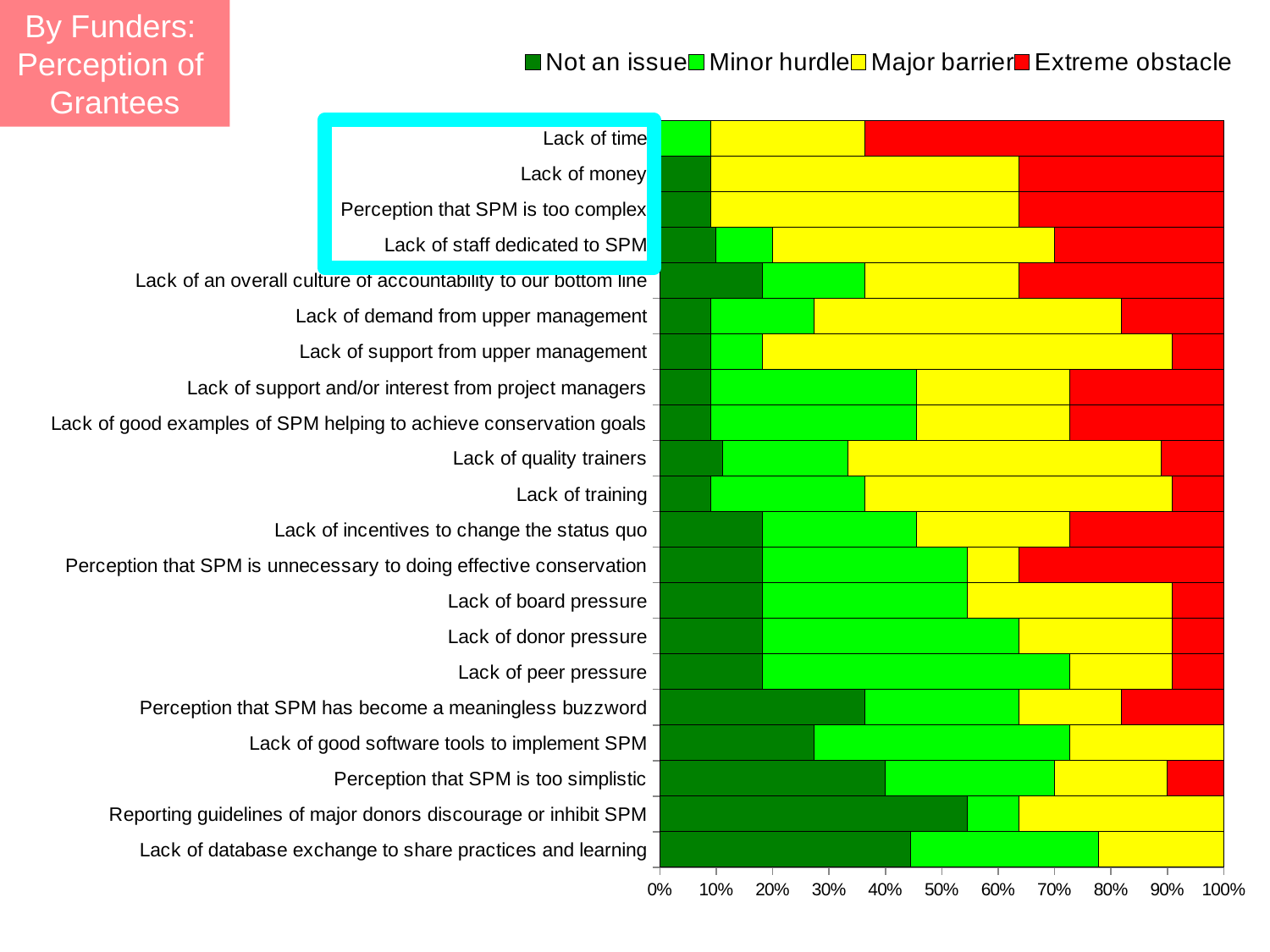
Which has the larger 'Extreme obstacle' share: 'Lack of time' or 'Lack of database exchange to share practices and learning'? Lack of time Is the 'Extreme obstacle' share for 'Lack of time' greater or less than 50%? greater Which category has the largest 'Extreme obstacle' share? Lack of time How many categories are plotted on the chart? 21 Is the 'Not an issue' share for 'Lack of database exchange to share practices and learning' greater or less than 30%? greater What does each stacked bar total on the x axis? 100% Which colour represents 'Extreme obstacle' in the legend? Red What kind of chart is shown on the slide? Stacked bar chart How many series does the legend list? 4 Which category has the largest 'Not an issue' share? Reporting guidelines of major donors discourage or inhibit SPM Is the 'Major barrier' share for 'Lack of money' greater or less than 40%? greater Which has the larger 'Not an issue' share: 'Lack of time' or 'Perception that SPM is too simplistic'? Perception that SPM is too simplistic